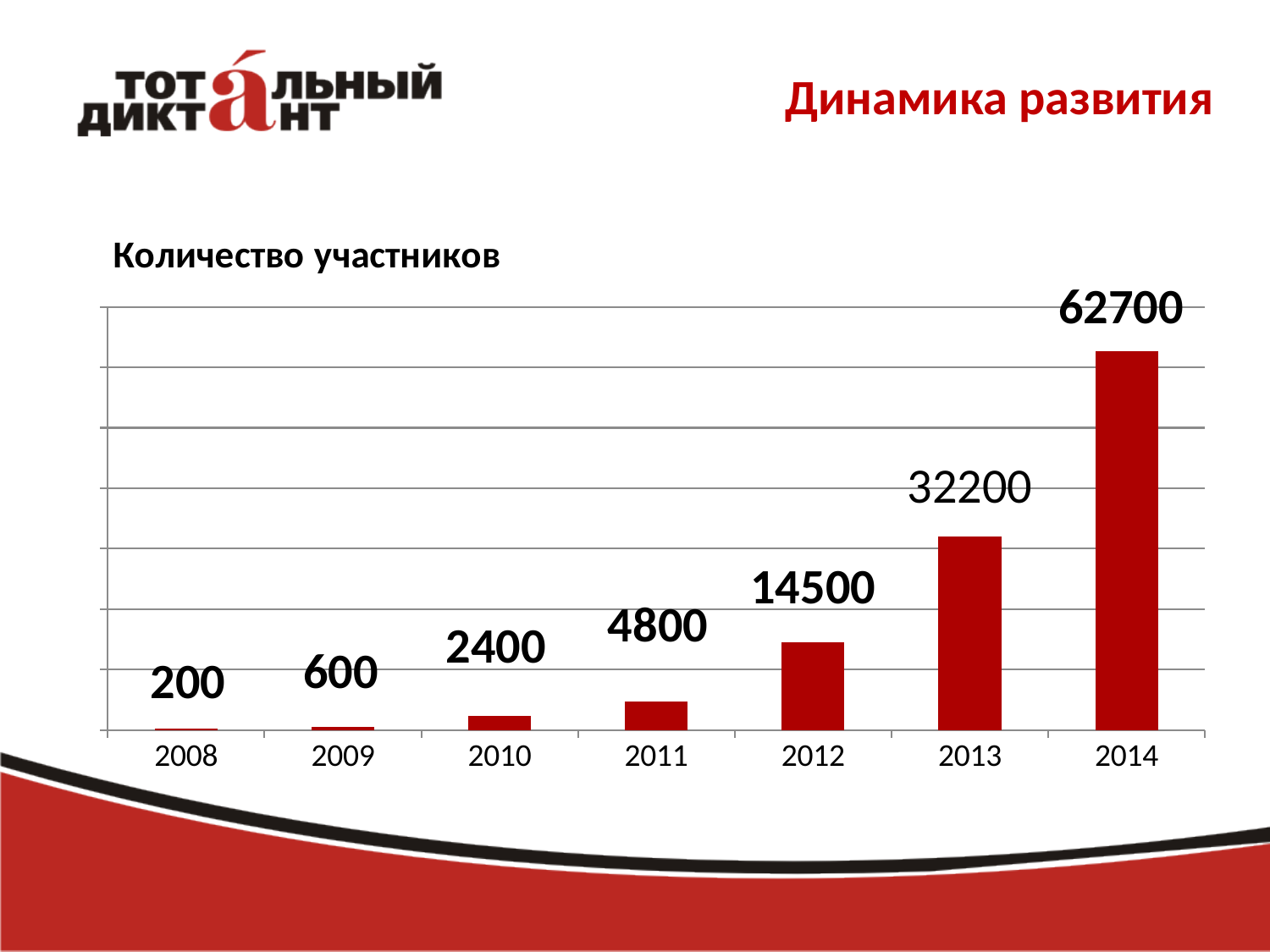
What kind of chart is shown on the slide? Bar chart Do the values rise or fall from 2008 to 2014? Rise Which year has the highest number of participants? 2014 What is the difference in participants between 2012 and 2011? 9700 What is the number of participants in 2008? 200 What is the number of participants in 2014? 62700 What is the number of participants in 2011? 4800 What is the title of the chart? Количество участников How many years are shown on the x axis? 7 Which year had more participants, 2010 or 2012? 2012 What is the difference in participants between 2014 and 2013? 30500 Which year has the lowest number of participants? 2008